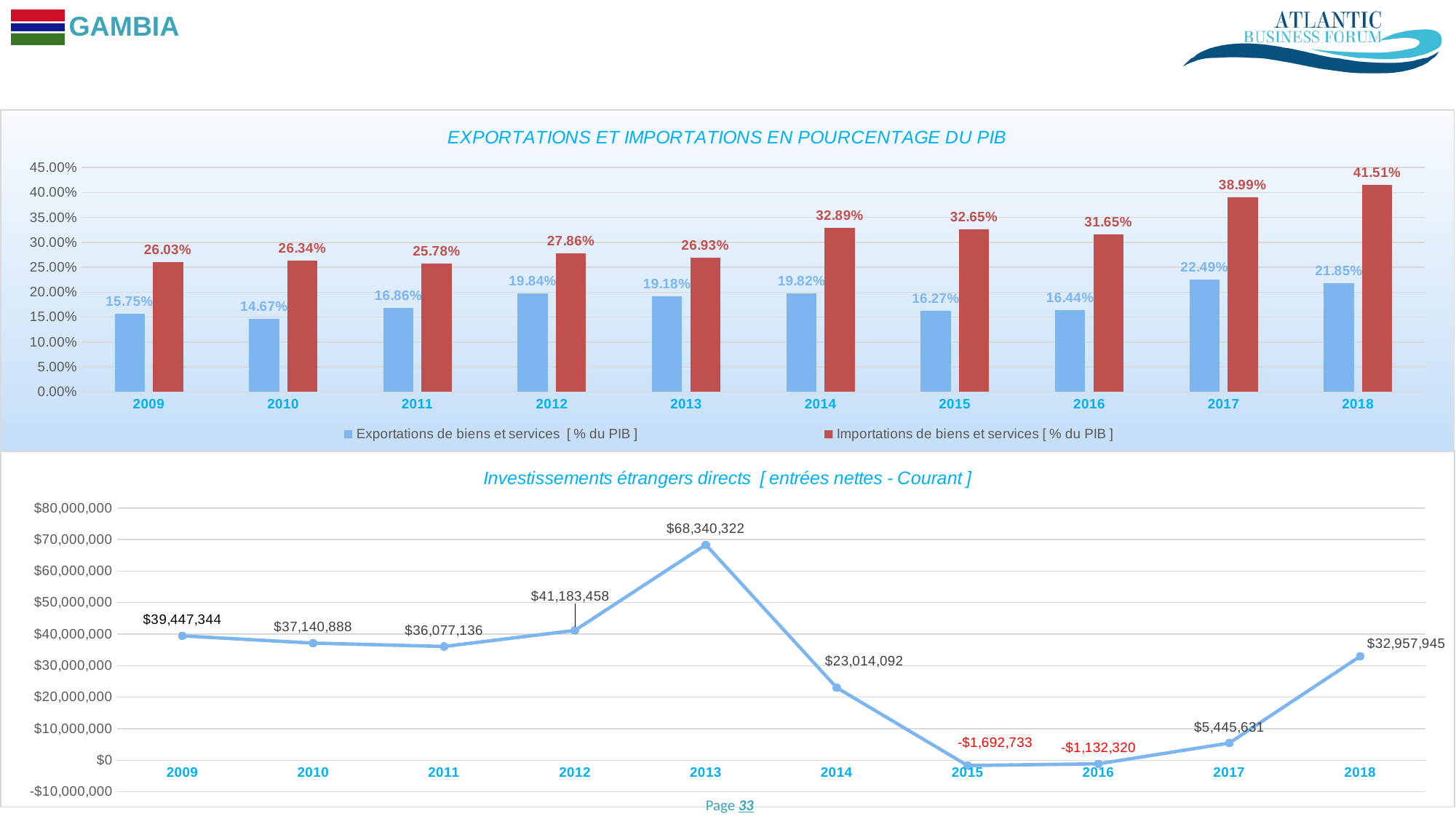
How many years are plotted in the chart 'Investissements étrangers directs'? 10 In the chart 'EXPORTATIONS ET IMPORTATIONS EN POURCENTAGE DU PIB', what is the value of Importations de biens et services for 2017? 38.99% What kind of chart is 'EXPORTATIONS ET IMPORTATIONS EN POURCENTAGE DU PIB'? Bar chart In the chart 'EXPORTATIONS ET IMPORTATIONS EN POURCENTAGE DU PIB', what is the difference between Importations and Exportations in 2018? 19.66% In the chart 'EXPORTATIONS ET IMPORTATIONS EN POURCENTAGE DU PIB', which year has the highest Importations value? 2018 In the chart 'EXPORTATIONS ET IMPORTATIONS EN POURCENTAGE DU PIB', how many series does the legend list? 2 In the chart 'EXPORTATIONS ET IMPORTATIONS EN POURCENTAGE DU PIB', which year has the lowest Exportations value? 2010 In the chart 'Investissements étrangers directs', what is the value for 2013? $68,340,322 In the chart 'Investissements étrangers directs', is the value for 2009 larger or smaller than the value for 2011? Larger In the chart 'EXPORTATIONS ET IMPORTATIONS EN POURCENTAGE DU PIB', what is the value of Exportations de biens et services for 2012? 19.84% In the chart 'Investissements étrangers directs', what is the value for 2015? -$1,692,733 In the chart 'Investissements étrangers directs', which year has the lowest value? 2015